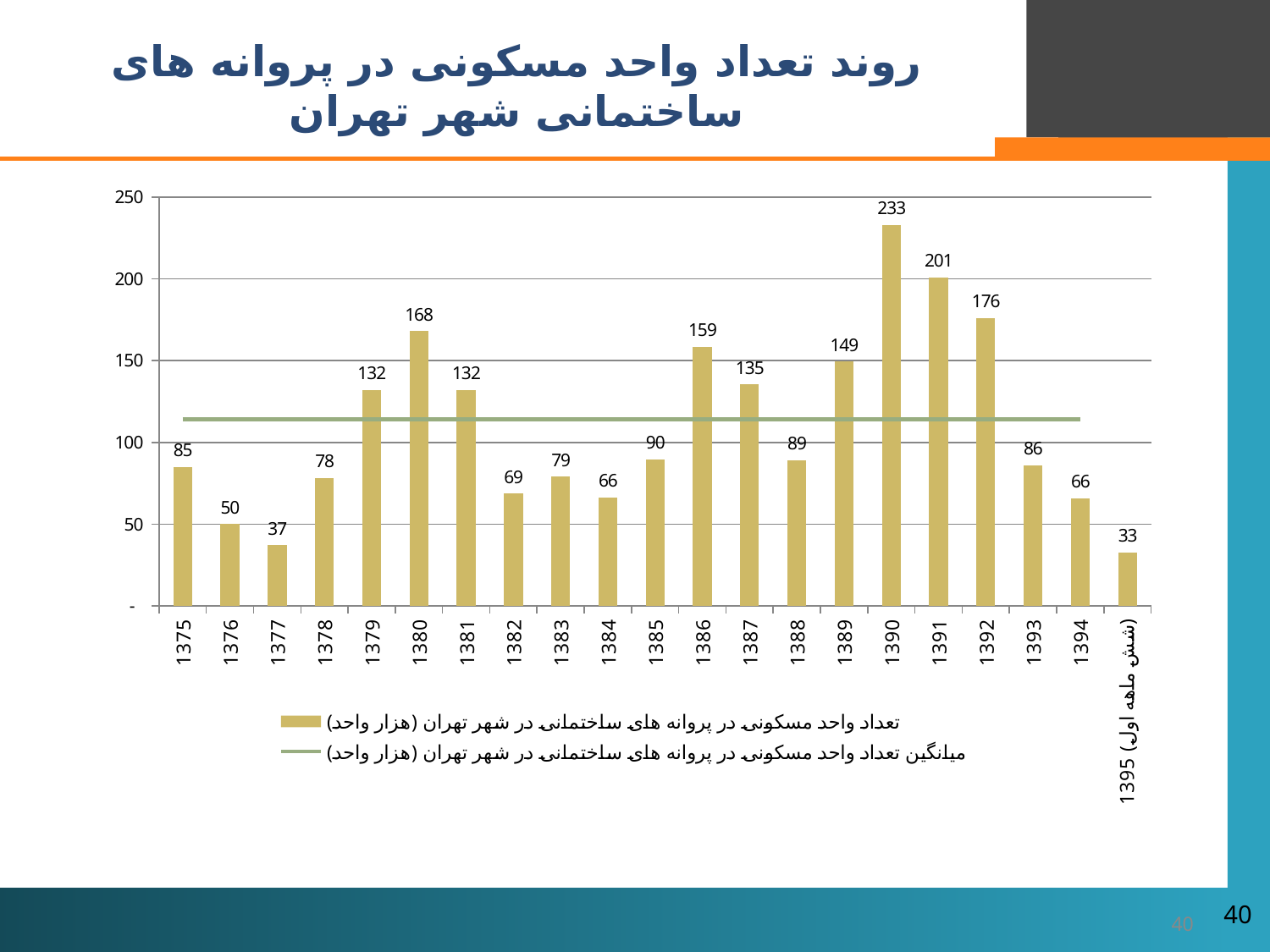
Which category has the lowest bar? 1395 (first six months) What is the value for 1380? 168 How many bars are plotted in the chart? 21 What is the value for 1377? 37 What is the value for 1390? 233 Which year has the highest bar? 1390 What is the difference between the values for 1391 and 1392? 25 Which is larger, the value for 1386 or the value for 1387? 1386 How many series does the legend list? 2 What kind of chart is shown on the slide? combination bar and line chart Do the values rise or fall from 1392 to 1395? fall Is the average line greater or less than 100? greater